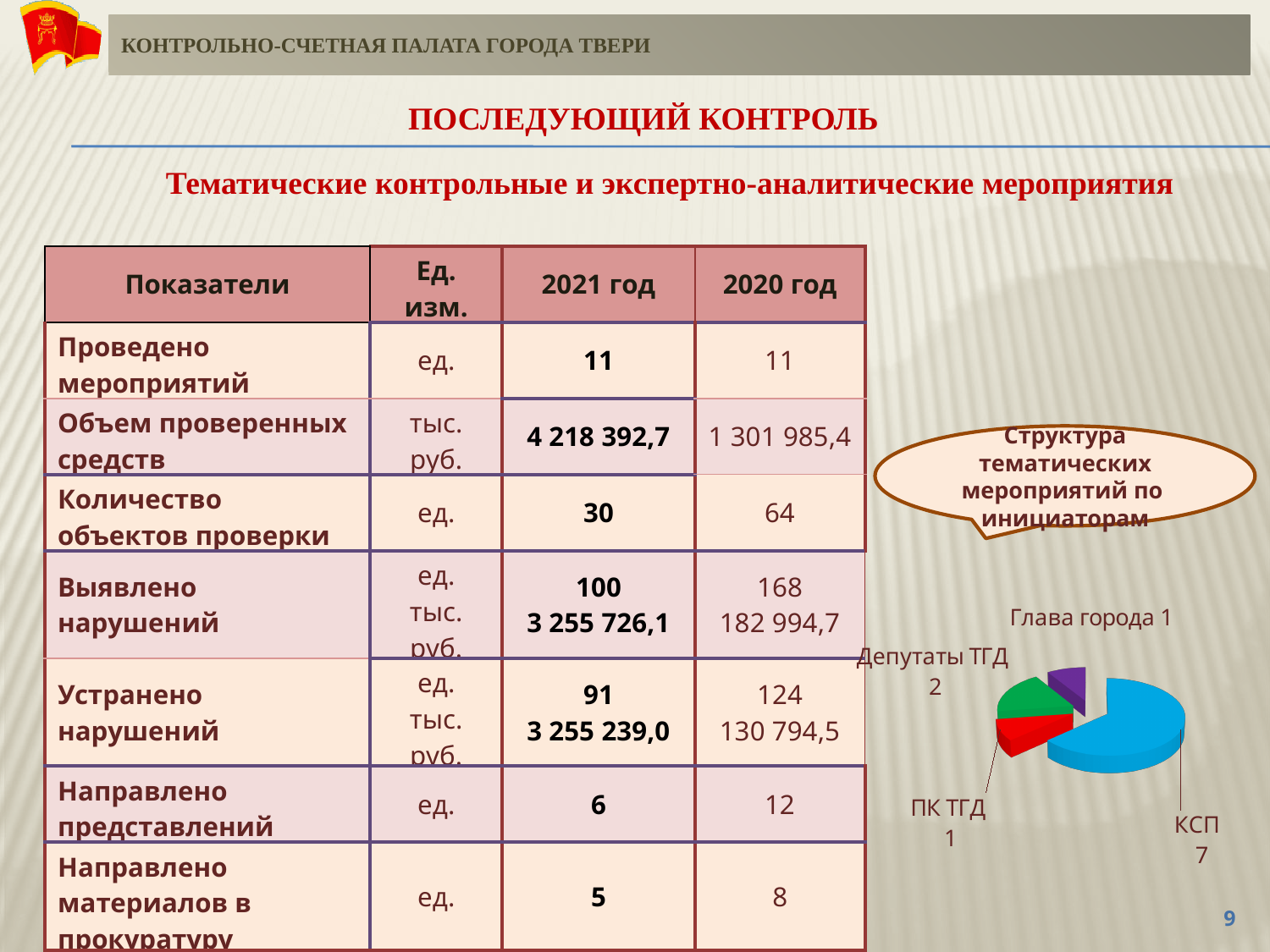
What is the title of the pie chart? Структура тематических мероприятий по инициаторам How many slices does the pie chart have? 4 Which initiator has the largest slice in the pie chart? КСП What is the value for КСП in the pie chart? 7 What is the value for Депутаты ТГД in the pie chart? 2 What kind of chart is shown on the slide? pie chart Which is larger in the pie chart, КСП or Депутаты ТГД? КСП What is the value for ПК ТГД in the pie chart? 1 What is the value for Глава города in the pie chart? 1 What is the difference between the values for КСП and Депутаты ТГД in the pie chart? 5 What is the total of all slice values in the pie chart? 11 What colour is the КСП slice in the pie chart? blue